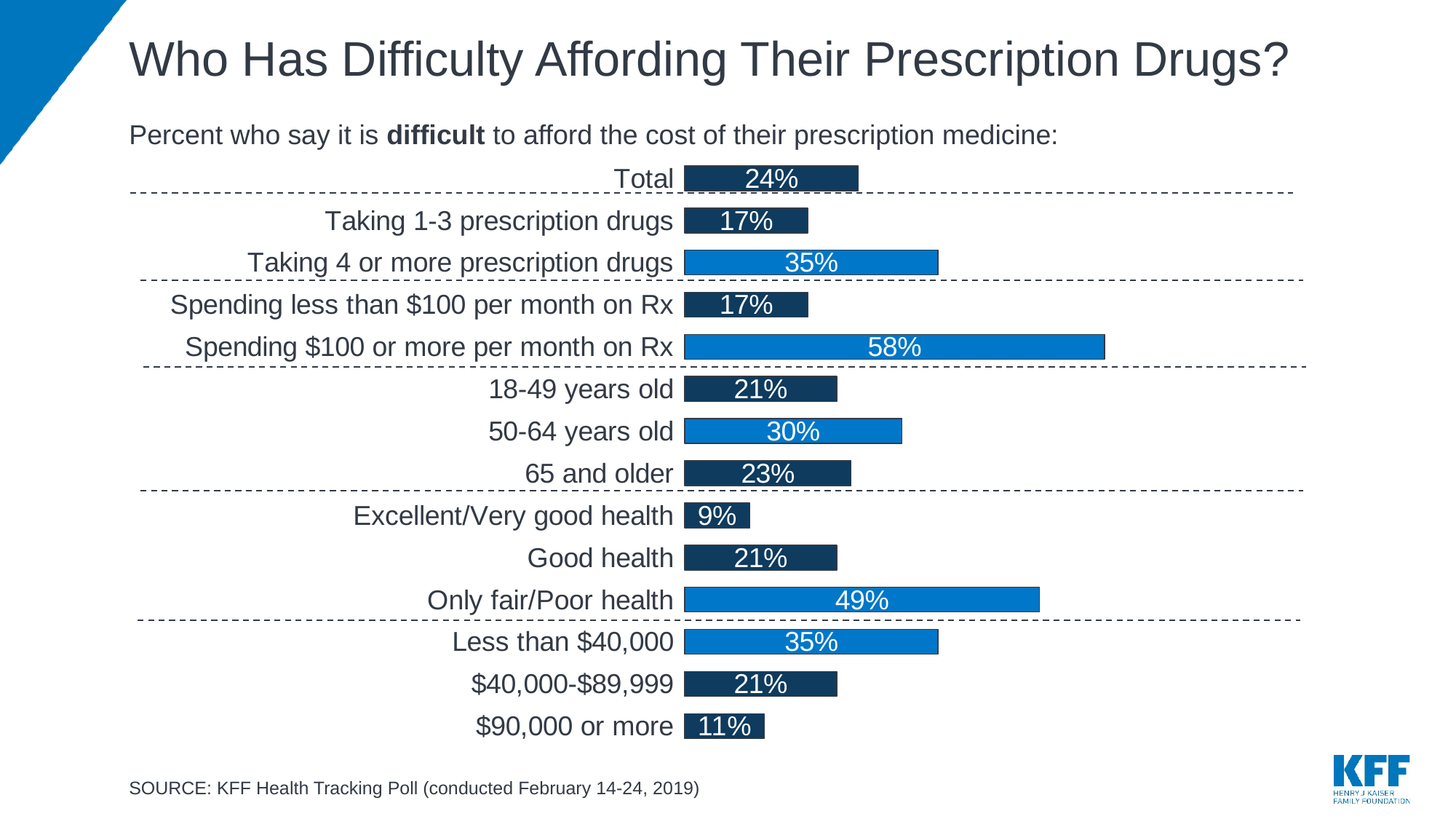
What kind of chart is shown on the slide? Bar chart What is the difference between those taking 4 or more prescription drugs and those taking 1-3 prescription drugs? 18 percentage points What percent of the Total say it is difficult to afford the cost of their prescription medicine? 24% How many categories (bars) are shown in the chart? 14 What is the title of the slide? Who Has Difficulty Affording Their Prescription Drugs? Which is larger: the value for 50-64 years old or the value for 65 and older? 50-64 years old What is the value for those spending $100 or more per month on Rx? 58% What is the value for people in Only fair/Poor health? 49% What is the value for those earning $90,000 or more? 11% What is the difference between those earning less than $40,000 and those earning $90,000 or more? 24 percentage points Which category has the lowest percentage? Excellent/Very good health Which category has the highest percentage saying it is difficult to afford their prescription medicine? Spending $100 or more per month on Rx